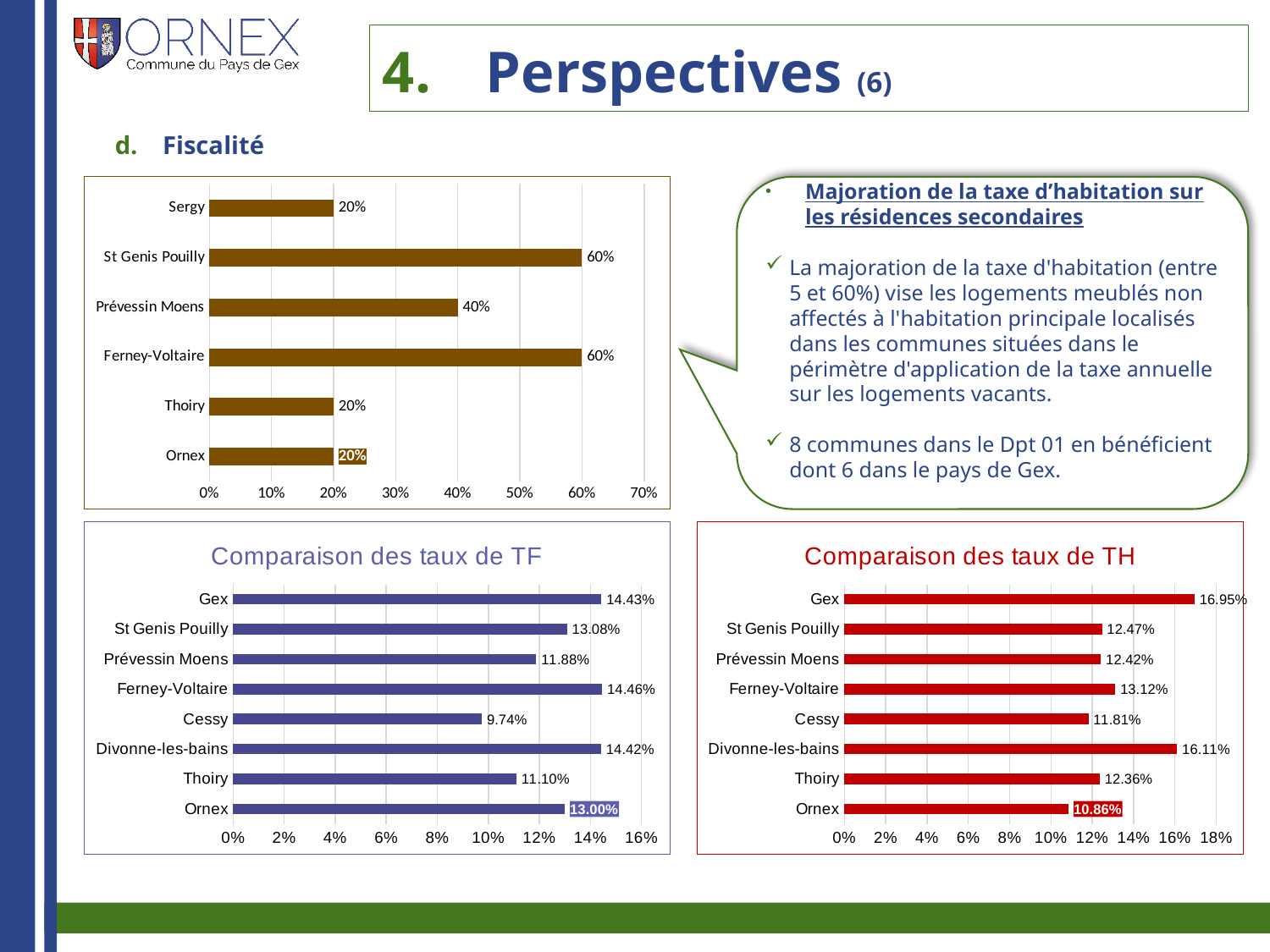
In the chart 'Comparaison des taux de TF', what is the value for Ornex? 13.00% In the top-left bar chart, what is the difference between the values for Ferney-Voltaire and Sergy? 40% In the chart 'Comparaison des taux de TH', which commune has the lowest rate? Ornex In the chart 'Comparaison des taux de TH', which is larger, the value for Ferney-Voltaire or the value for Cessy? Ferney-Voltaire What kind of chart is 'Comparaison des taux de TH'? Bar chart How many communes are shown in the top-left bar chart? 6 In the chart 'Comparaison des taux de TH', what is the value for Divonne-les-bains? 16.11% In the chart 'Comparaison des taux de TF', what is the value for Cessy? 9.74% In the chart 'Comparaison des taux de TF', which commune has the lowest rate? Cessy In the top-left bar chart, what is the value for Prévessin Moens? 40% In the chart 'Comparaison des taux de TH', which commune has the highest rate? Gex In the top-left bar chart, what is the value for St Genis Pouilly? 60%